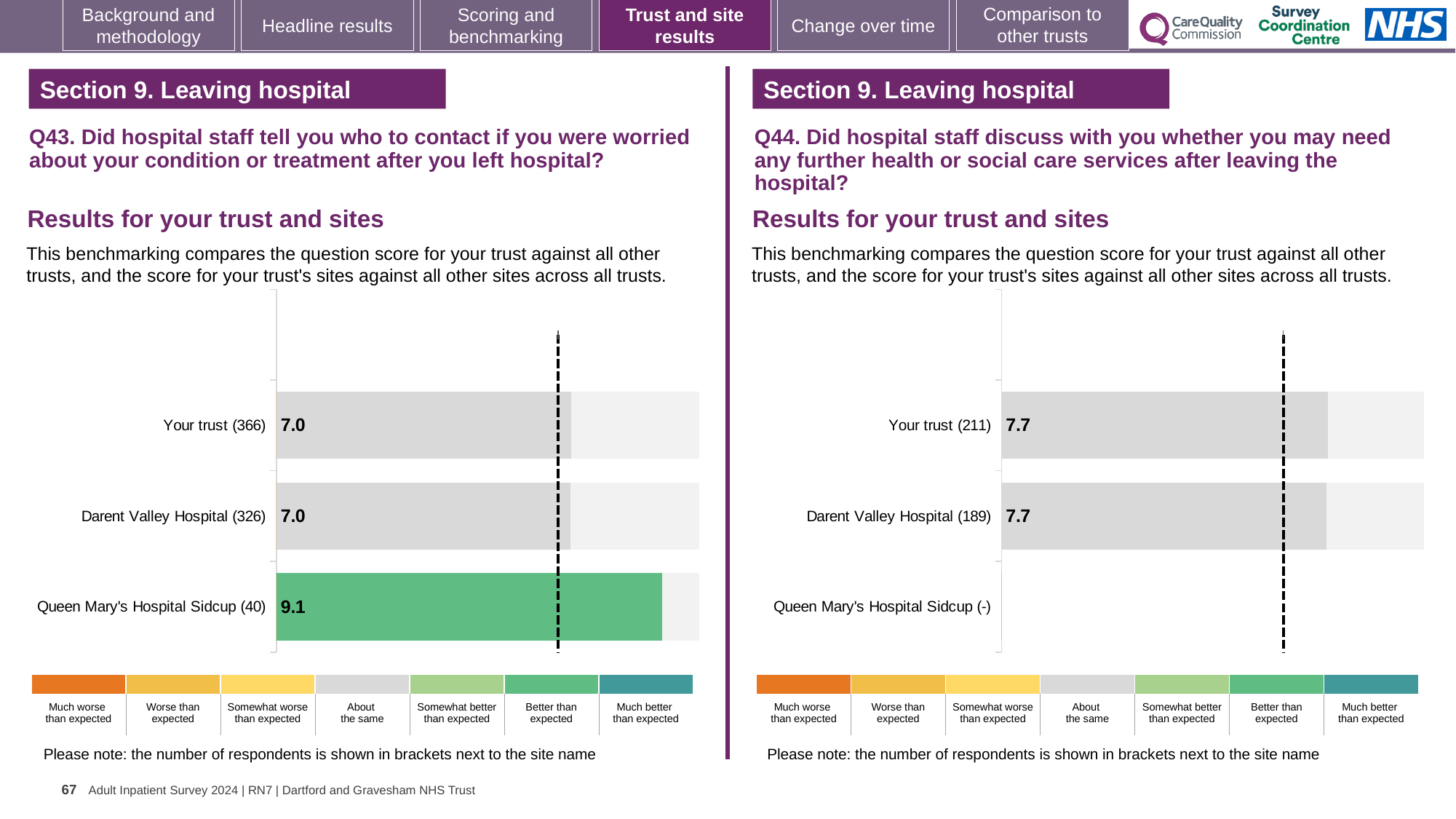
In the Q43 chart on the left, which site has the highest score? Queen Mary's Hospital Sidcup In the Q44 chart on the right, what is the score for Darent Valley Hospital? 7.7 In the Q43 chart on the left, what is the difference between the scores for Queen Mary's Hospital Sidcup and Darent Valley Hospital? 2.1 In the Q44 chart on the right, how many respondents are shown for Your trust? 211 In the Q43 chart on the left, what is the score for Your trust? 7.0 Is the score for Your trust higher in the Q43 chart on the left or the Q44 chart on the right? Q44 chart on the right In the Q43 chart on the left, which benchmark category does the colour of the Queen Mary's Hospital Sidcup bar correspond to? Better than expected In the Q43 chart on the left, how many respondents are shown for Queen Mary's Hospital Sidcup? 40 In the Q44 chart on the right, is a score shown for Queen Mary's Hospital Sidcup? No In the Q43 chart on the left, how many bars (rows) are plotted? 3 What type of chart is used on the left for Q43? Bar chart In the Q43 chart on the left, what is the score for Queen Mary's Hospital Sidcup? 9.1